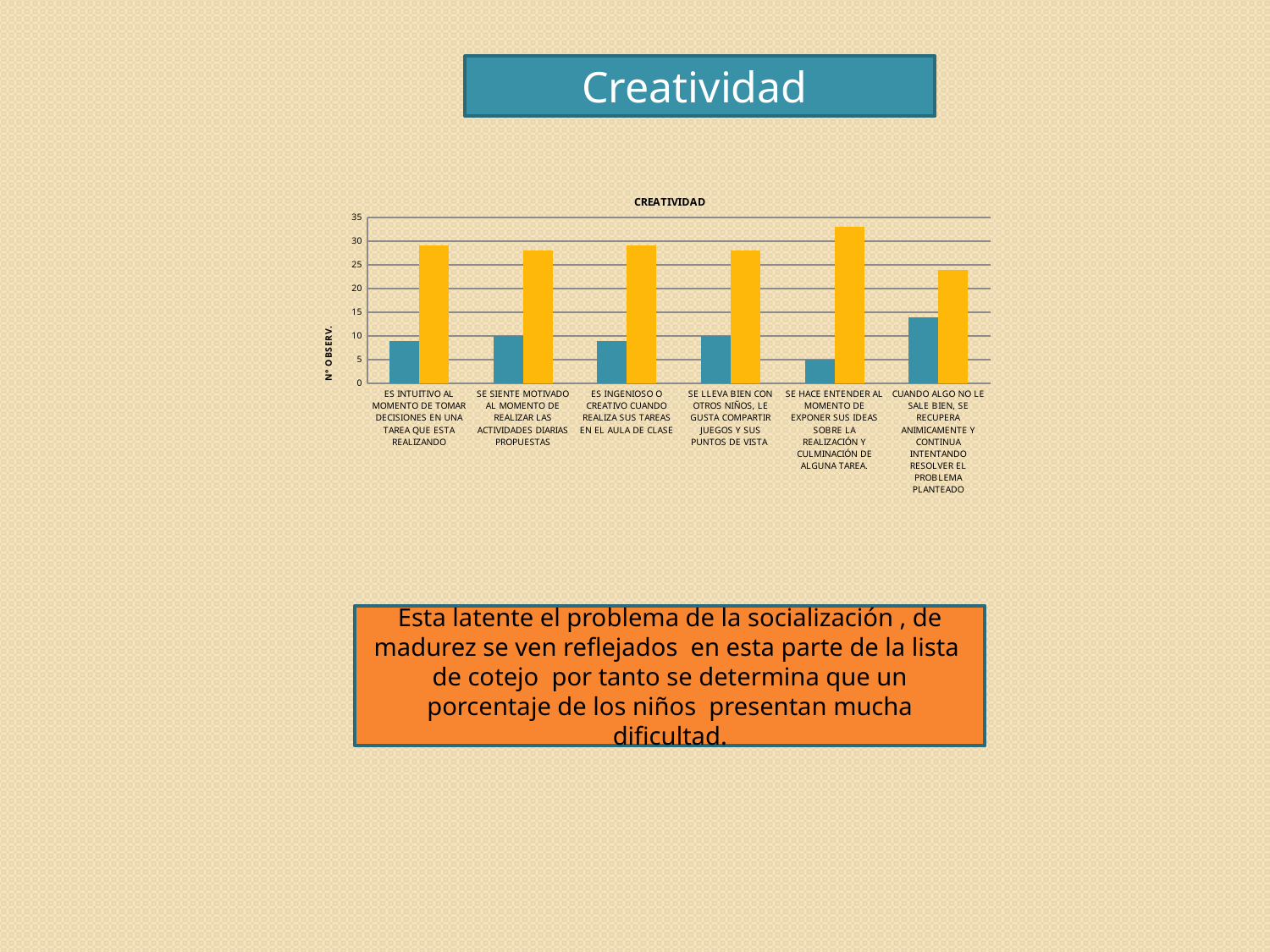
For which category is the blue bar the shortest? SE HACE ENTENDER AL MOMENTO DE EXPONER SUS IDEAS SOBRE LA REALIZACIÓN Y CULMINACIÓN DE ALGUNA TAREA. How many bars are plotted for each category in the CREATIVIDAD chart? 2 What kind of chart is shown on the slide? bar chart For "ES INGENIOSO O CREATIVO CUANDO REALIZA SUS TAREAS EN EL AULA DE CLASE", which bar is taller, the blue one or the yellow one? the yellow one Is the blue bar for "ES INTUITIVO AL MOMENTO DE TOMAR DECISIONES" greater or less than 15? less What is the label on the vertical axis of the chart? N° OBSERV. How many categories are shown along the x axis of the CREATIVIDAD chart? 6 Is the yellow bar for "SE HACE ENTENDER AL MOMENTO DE EXPONER SUS IDEAS" greater or less than 30? greater Is the blue bar for "CUANDO ALGO NO LE SALE BIEN" greater or less than 10? greater For which category is the yellow bar the shortest? CUANDO ALGO NO LE SALE BIEN, SE RECUPERA ANIMICAMENTE Y CONTINUA INTENTANDO RESOLVER EL PROBLEMA PLANTEADO For which category is the yellow bar the tallest? SE HACE ENTENDER AL MOMENTO DE EXPONER SUS IDEAS SOBRE LA REALIZACIÓN Y CULMINACIÓN DE ALGUNA TAREA. For which category is the blue bar the tallest? CUANDO ALGO NO LE SALE BIEN, SE RECUPERA ANIMICAMENTE Y CONTINUA INTENTANDO RESOLVER EL PROBLEMA PLANTEADO